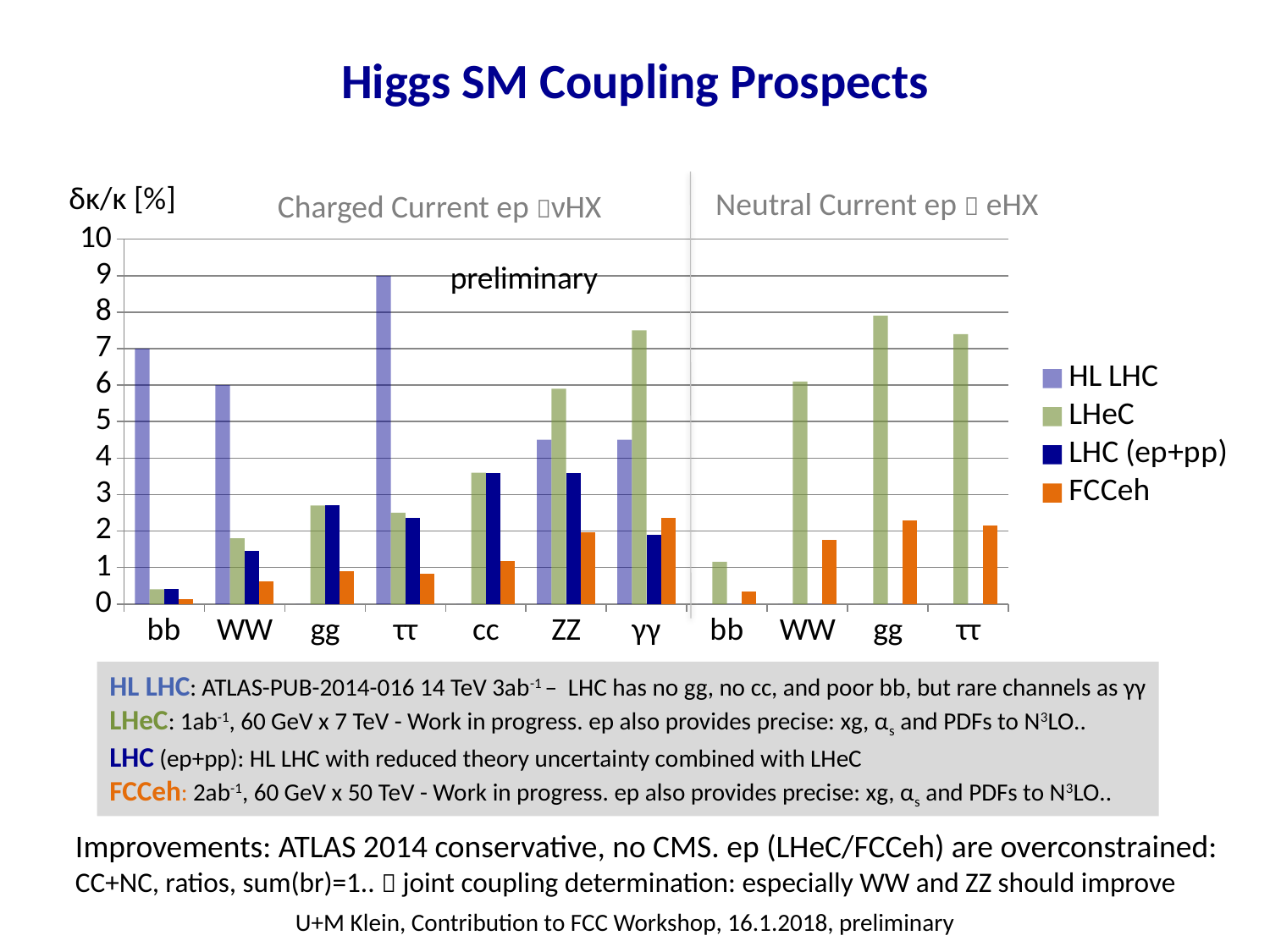
What is the HL LHC value for bb in the Charged Current section? 7 What is the label on the y axis of the chart? δκ/κ [%] What is the HL LHC value for ττ in the Charged Current section? 9 What is the difference between the HL LHC values for bb and WW in the Charged Current section? 1 How many series does the legend list? 4 How many categories are shown along the x axis in total? 11 Which category has the highest HL LHC bar? ττ For γγ, which is larger: the LHeC value or the HL LHC value? LHeC Is the LHeC value for gg in the Neutral Current section greater or less than 7? greater What kind of chart is shown on the slide? bar chart Is the FCCeh value for bb in the Charged Current section greater or less than 1? less In the Charged Current section, which is larger: the HL LHC value for bb or for WW? bb